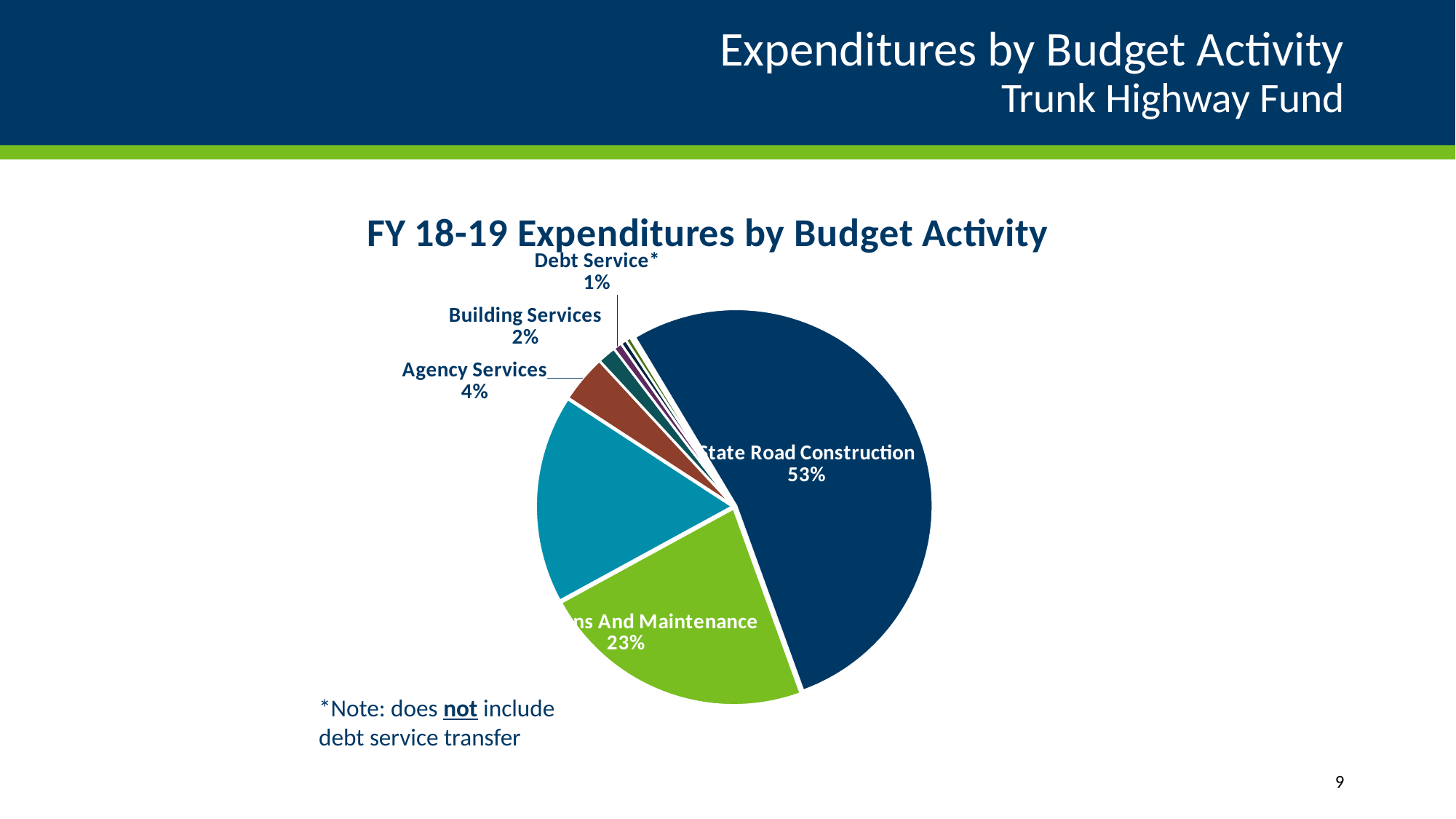
Which is larger, Agency Services or Building Services? Agency Services What percentage is shown for Agency Services? 4% Which budget activity has the largest share of the pie? State Road Construction What is the title of the chart? FY 18-19 Expenditures by Budget Activity What kind of chart is shown on the slide? pie chart What percentage is shown on the green slice labelled '...And Maintenance'? 23% What colour is the State Road Construction slice? dark blue Which of the labelled slices has the smallest share? Debt Service* What percentage is shown for Debt Service*? 1% What share of FY 18-19 expenditures goes to State Road Construction? 53% How many percentage points larger is State Road Construction than the green '...And Maintenance' slice? 30 percentage points What percentage is shown for Building Services? 2%